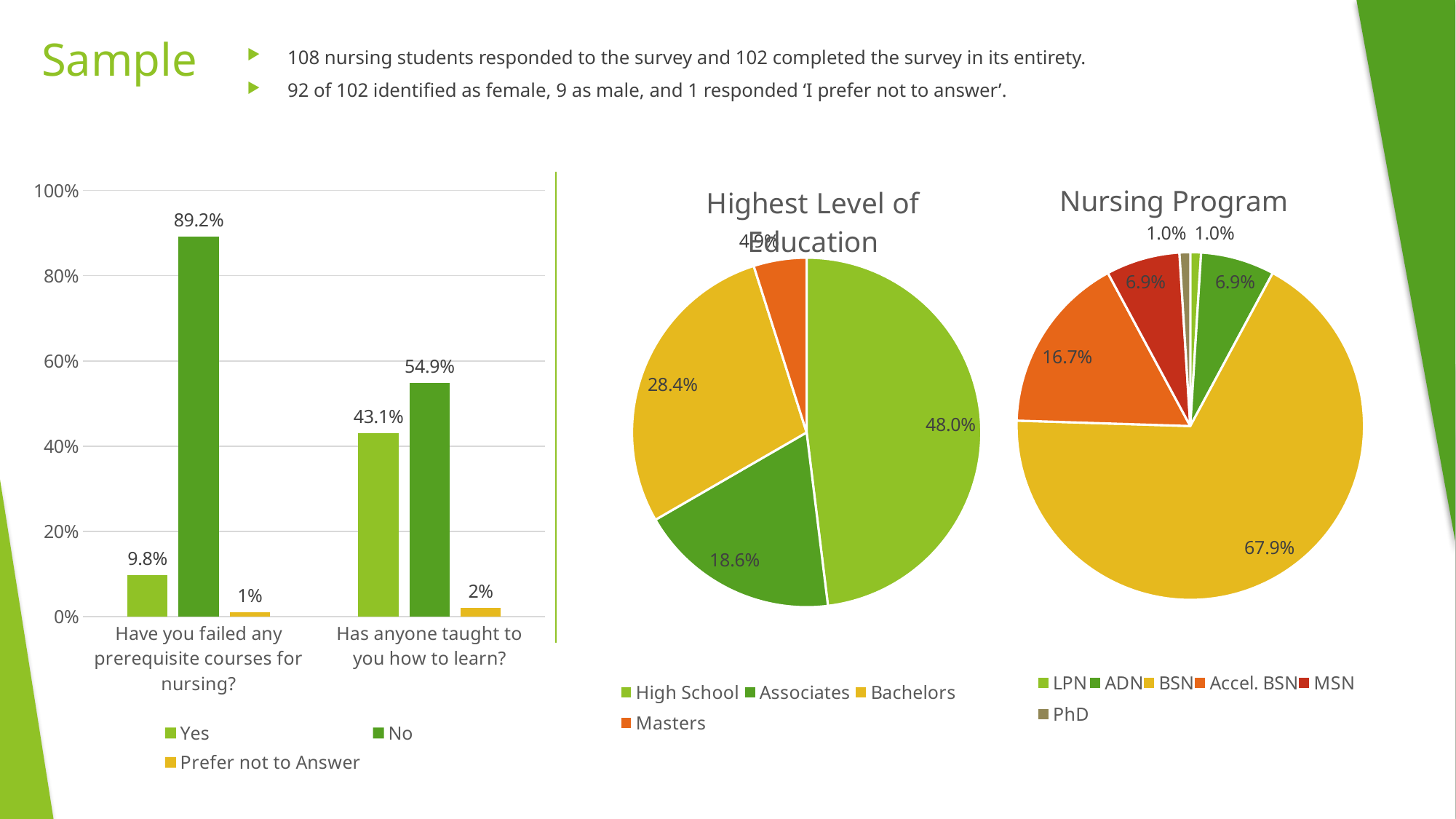
In the bar chart on the left, what is the difference between the "No" and "Yes" values for "Has anyone taught to you how to learn?" 11.8% What kind of chart is the chart on the left of the slide? Bar chart In the "Highest Level of Education" chart, what is the value for Associates? 18.6% In the bar chart on the left, what is the value for "Yes" for the question "Has anyone taught to you how to learn?" 43.1% In the "Nursing Program" chart, how many categories does the legend list? 6 In the "Highest Level of Education" chart, what share of the pie is Bachelors? 28.4% In the bar chart on the left, how many series does the legend list? 3 In the "Nursing Program" chart, what is the value for Accel. BSN? 16.7% In the "Nursing Program" chart, what is the value for BSN? 67.9% In the bar chart on the left, what is the value for "No" for the question "Have you failed any prerequisite courses for nursing?" 89.2% In the "Highest Level of Education" chart, which category has the largest slice? High School In the bar chart on the left, what is the value for "Prefer not to Answer" for the question "Has anyone taught to you how to learn?" 2%